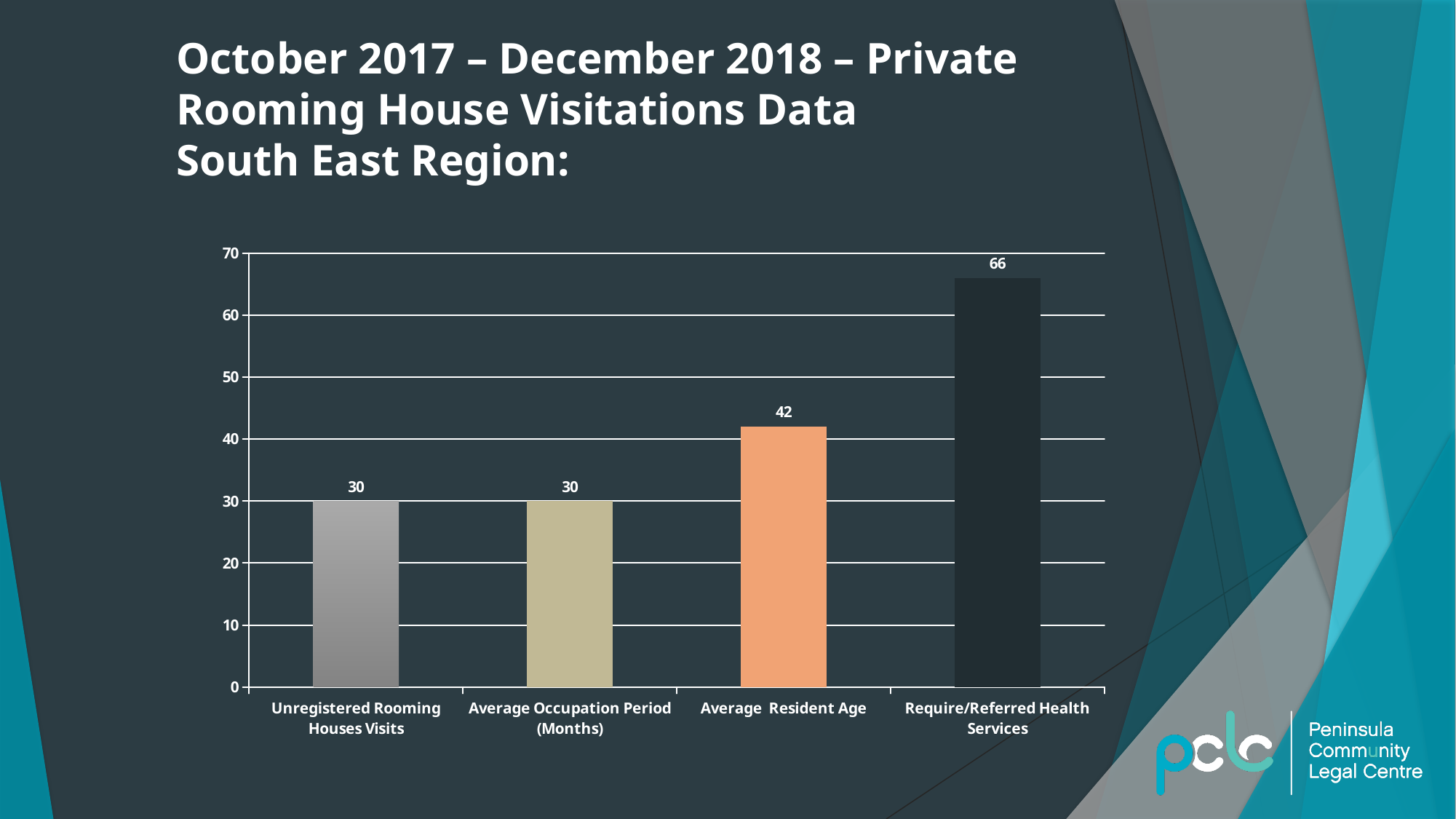
Which category has the highest value? Require/Referred Health Services What is the difference between the values for Require/Referred Health Services and Average Resident Age? 24 What is the value for Unregistered Rooming Houses Visits? 30 What kind of chart is shown on the slide? bar chart Is the value for Require/Referred Health Services greater or less than 60? greater What is the value for Average Resident Age? 42 What is the value for Average Occupation Period (Months)? 30 What is the highest value shown on the vertical axis? 70 What is the value for Require/Referred Health Services? 66 What is the difference between the values for Average Resident Age and Unregistered Rooming Houses Visits? 12 Which is larger, the value for Average Resident Age or the value for Average Occupation Period (Months)? Average Resident Age How many categories are shown on the x axis? 4